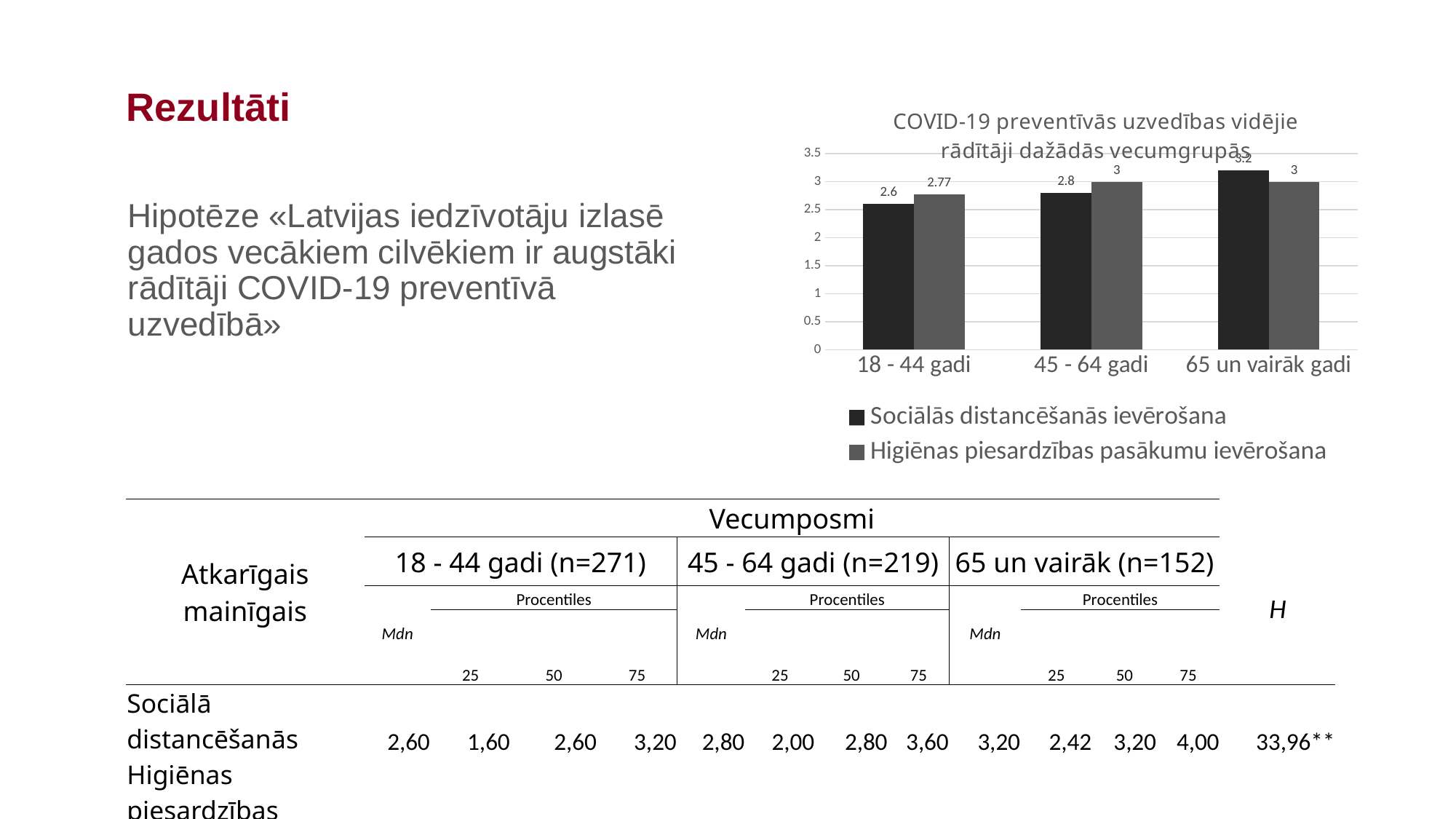
In the 45 - 64 gadi group, which series has the larger value: Sociālās distancēšanās ievērošana or Higiēnas piesardzības pasākumu ievērošana? Higiēnas piesardzības pasākumu ievērošana What is the value for Higiēnas piesardzības pasākumu ievērošana in the 45 - 64 gadi group? 3 How many age groups are shown on the x axis of the chart? 3 Which age group has the lowest value for Higiēnas piesardzības pasākumu ievērošana? 18 - 44 gadi How many series does the chart legend list? 2 What is the value for Sociālās distancēšanās ievērošana in the 18 - 44 gadi group? 2.6 What is the difference between the Sociālās distancēšanās ievērošana values for the 65 un vairāk gadi and 18 - 44 gadi groups? 0.6 What is the value for Sociālās distancēšanās ievērošana in the 65 un vairāk gadi group? 3.2 Which age group has the highest value for Sociālās distancēšanās ievērošana? 65 un vairāk gadi What is the value for Higiēnas piesardzības pasākumu ievērošana in the 18 - 44 gadi group? 2.77 Does the value for Sociālās distancēšanās ievērošana rise or fall across the age groups from left to right? rise Is the value for Sociālās distancēšanās ievērošana in the 18 - 44 gadi group greater or less than 3? less